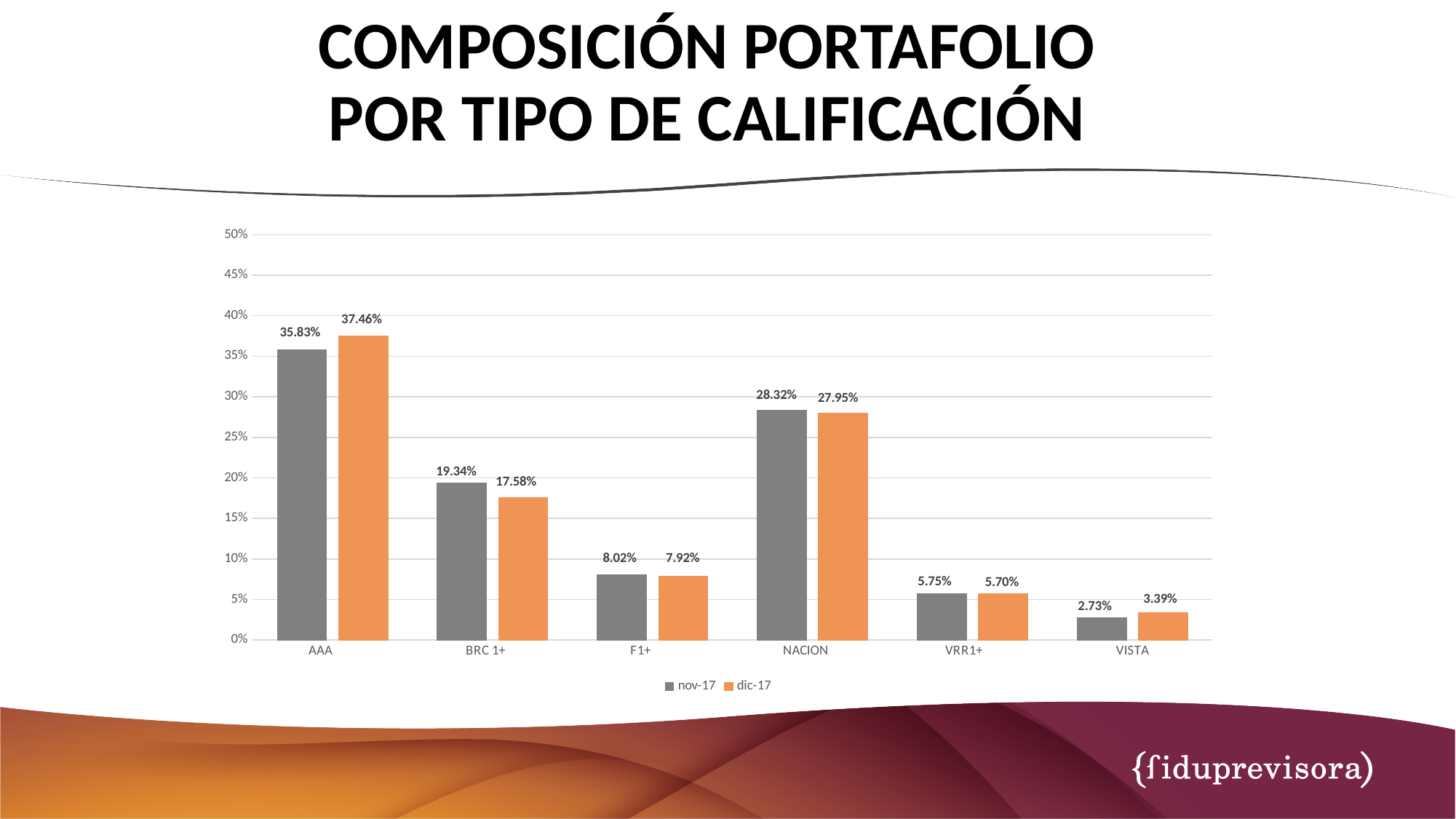
What kind of chart is shown on the slide? bar chart What colour are the dic-17 bars? orange Which is larger for F1+: the nov-17 value or the dic-17 value? nov-17 What is the difference between the nov-17 and dic-17 values for BRC 1+? 1.76% Is the dic-17 value for NACION greater or less than 30%? less What is the value for VISTA in the dic-17 series? 3.39% What is the value for AAA in the dic-17 series? 37.46% How many series does the legend list? 2 Which category has the lowest value in the dic-17 series? VISTA How many categories are shown on the x axis? 6 What is the value for NACION in the nov-17 series? 28.32% Which category has the highest value in the nov-17 series? AAA